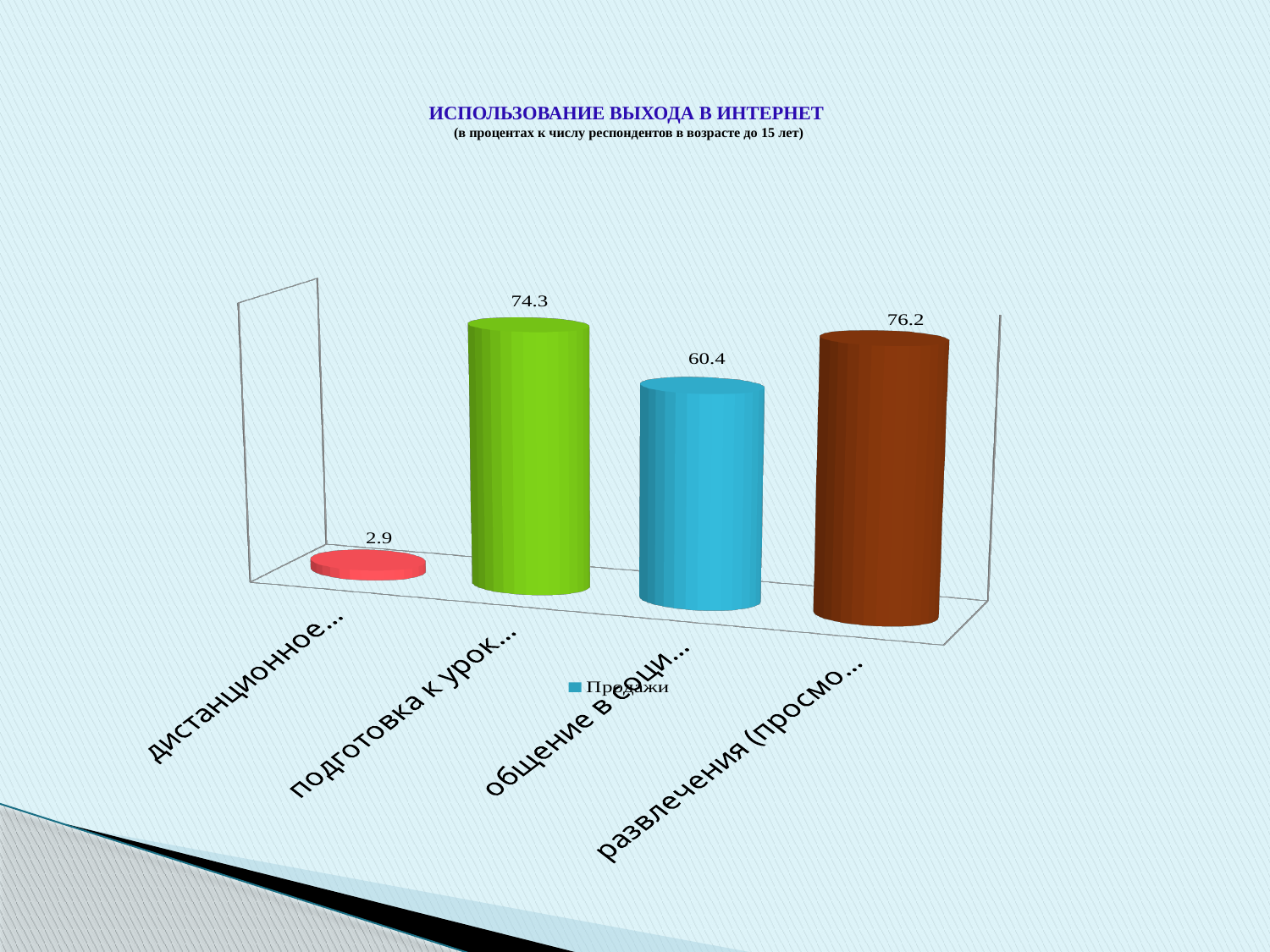
Which is larger, the value for "подготовка к урок..." or the value for "общение в соци..."? подготовка к урок... Which category has the highest value? развлечения (просмо... What is the value for the category labelled "общение в соци..."? 60.4 What series name does the legend show? Продажи How many categories are shown in the chart? 4 What is the difference between the values for "развлечения (просмо..." and "общение в соци..."? 15.8 What is the value for the category labelled "подготовка к урок..."? 74.3 What is the value for the category labelled "дистанционное..."? 2.9 What kind of chart is shown on the slide? Bar chart What is the difference between the values for "подготовка к урок..." and "дистанционное..."? 71.4 Which category has the lowest value? дистанционное... What is the value for the category labelled "развлечения (просмо..."? 76.2